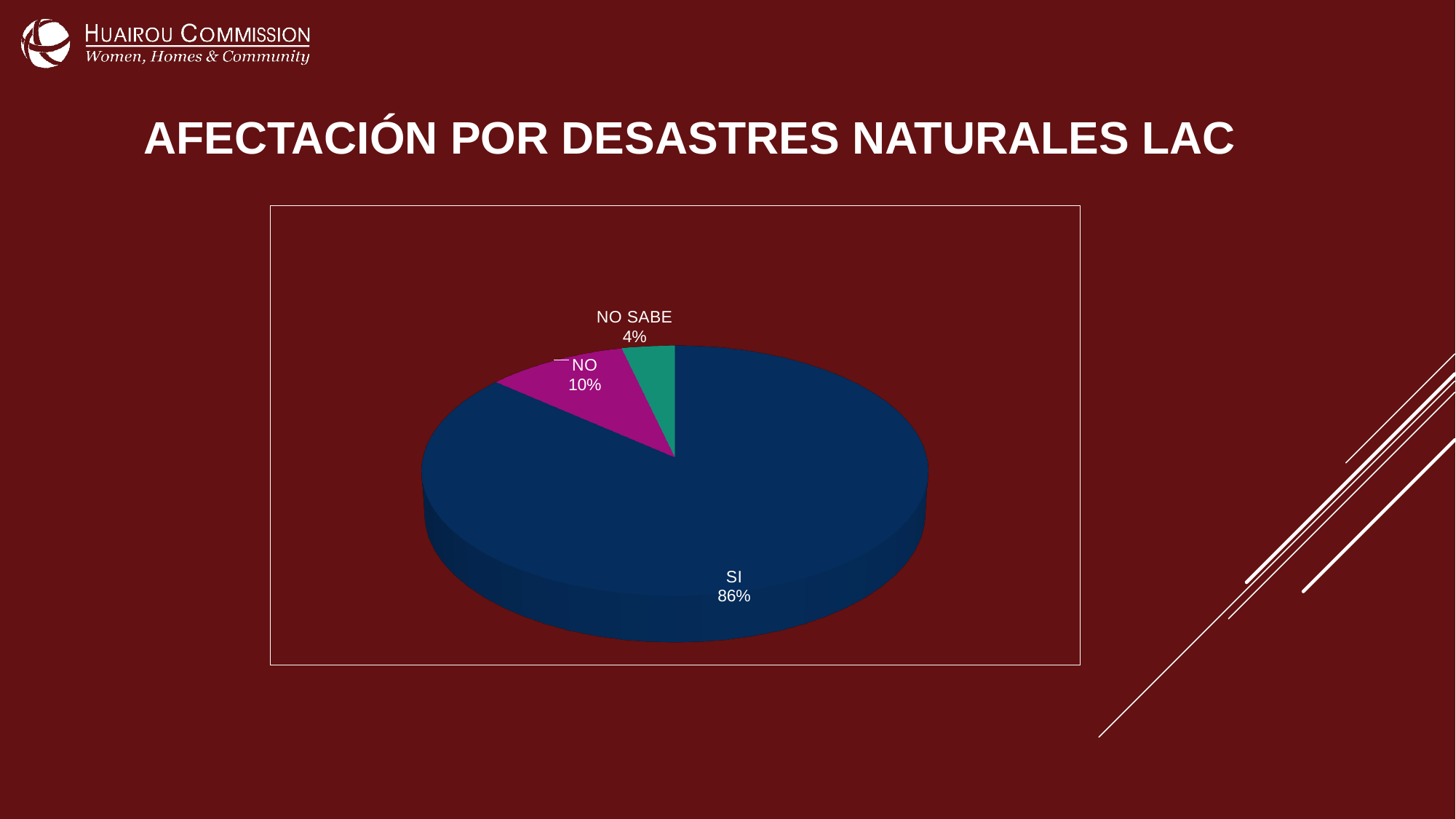
What kind of chart is shown on the slide? Pie chart Which category has the smallest share of the pie chart? NO SABE What colour is the SI slice of the pie chart? Dark blue What percentage of the pie chart is labelled NO? 10% Which slice is larger, NO or NO SABE? NO What percentage of the pie chart is labelled SI? 86% What percentage of the pie chart is labelled NO SABE? 4% How many slices does the pie chart have? 3 What is the difference in percentage points between the SI and NO slices? 76 Which category has the largest share of the pie chart? SI What is the title of the slide containing the chart? AFECTACIÓN POR DESASTRES NATURALES LAC What is the difference in percentage points between the NO and NO SABE slices? 6